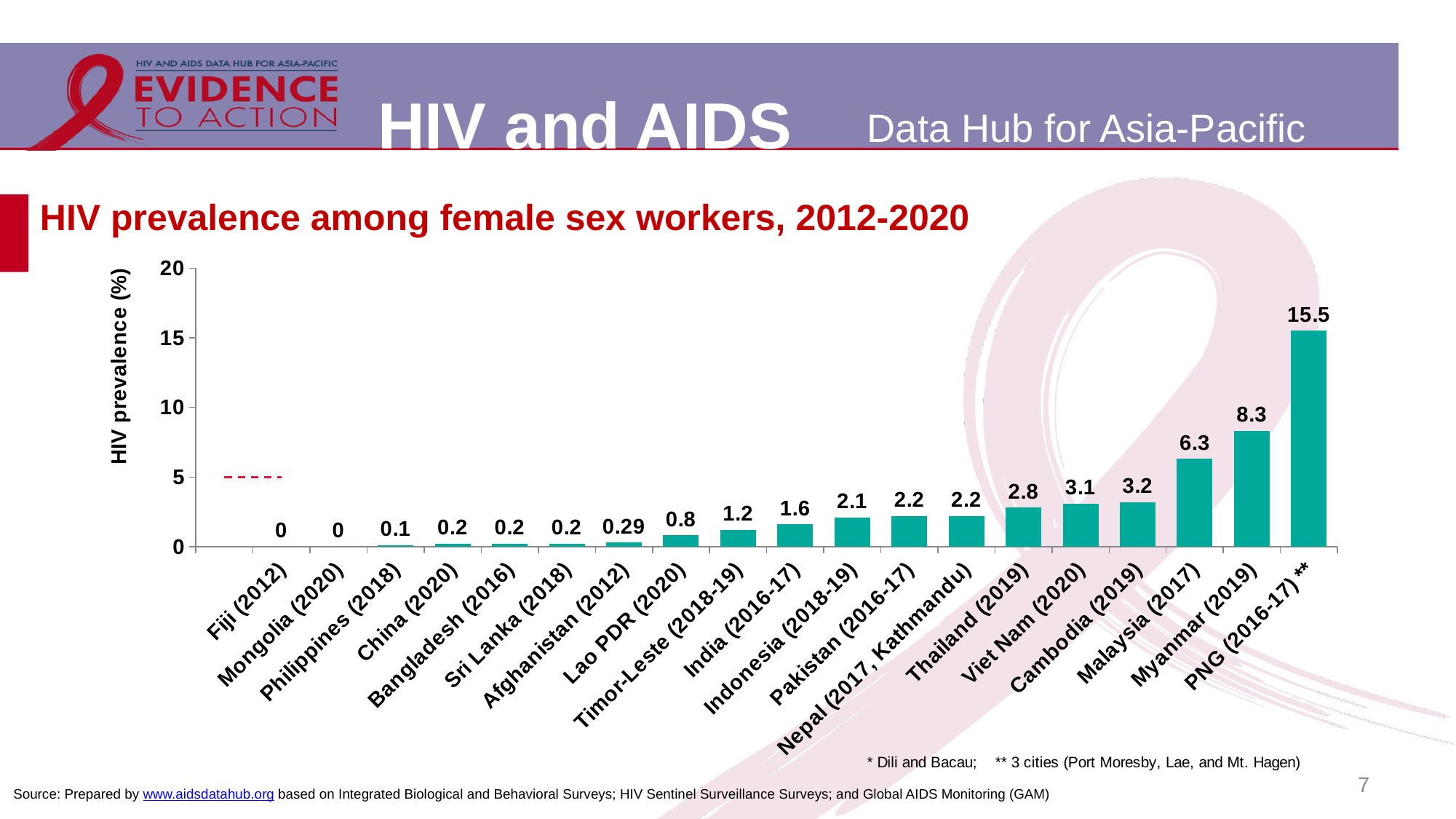
What is the difference in HIV prevalence between PNG (2016-17) and Myanmar (2019)? 7.2 What kind of chart is shown on the slide? Bar chart What is the HIV prevalence among female sex workers in Afghanistan (2012)? 0.29 What is the difference in HIV prevalence between Malaysia (2017) and Cambodia (2019)? 3.1 What is the HIV prevalence among female sex workers in PNG (2016-17)? 15.5 What is the HIV prevalence among female sex workers in Thailand (2019)? 2.8 What is the HIV prevalence among female sex workers in Myanmar (2019)? 8.3 Which has a higher HIV prevalence among female sex workers, Viet Nam (2020) or Lao PDR (2020)? Viet Nam (2020) How many countries are shown on the chart? 19 Which country has the highest HIV prevalence among female sex workers on the chart? PNG (2016-17) What is the label of the vertical axis? HIV prevalence (%) Is the value for Malaysia (2017) greater or less than 5? greater